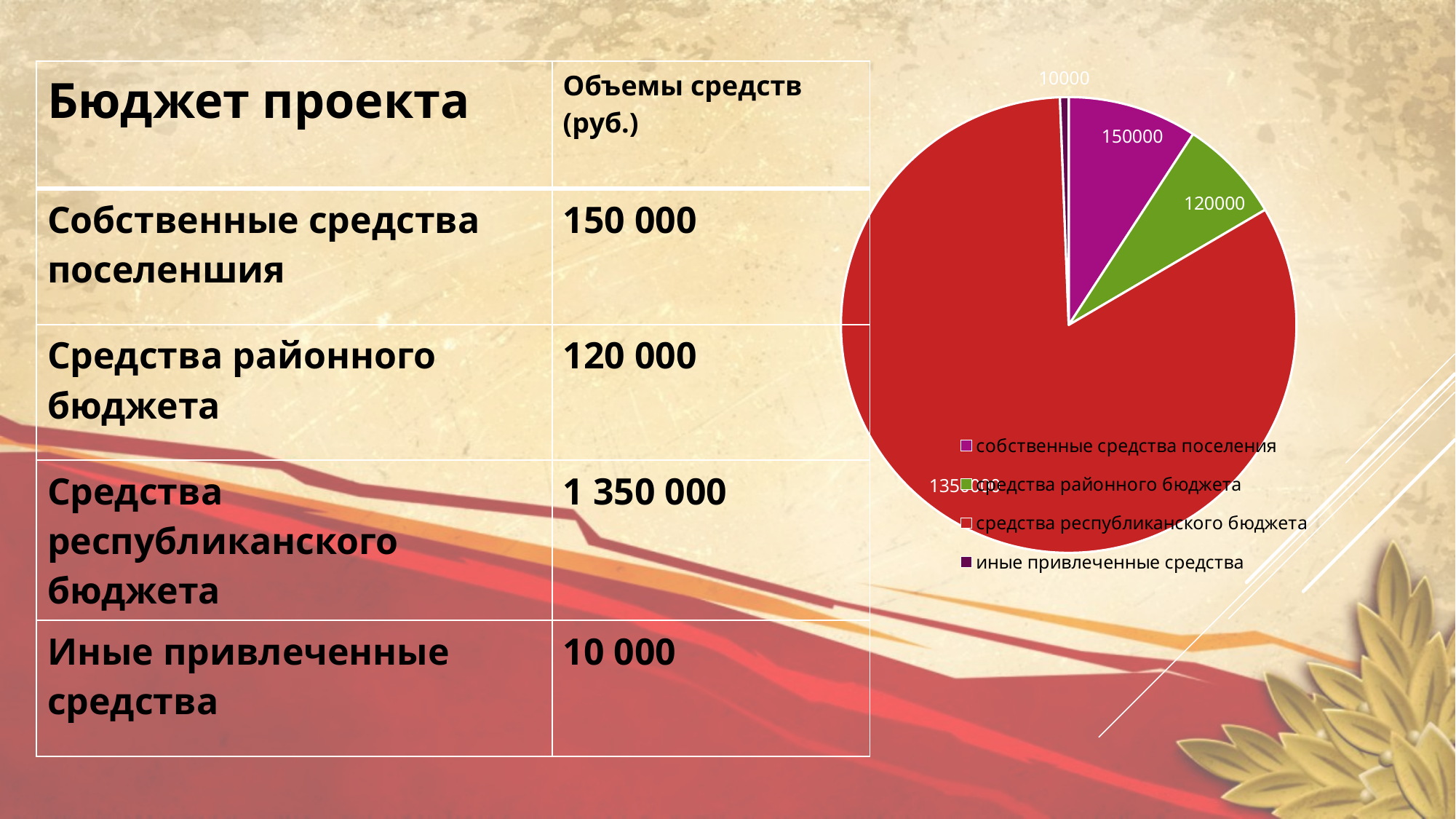
Which category has the largest slice in the pie chart? средства республиканского бюджета What is the value of the slice for собственные средства поселения in the pie chart? 150000 What is the value of the slice for средства республиканского бюджета in the pie chart? 1350000 How many slices does the pie chart have? 4 What is the difference between the values for собственные средства поселения and средства районного бюджета in the pie chart? 30000 What is the value of the slice for средства районного бюджета in the pie chart? 120000 Which is larger in the pie chart: собственные средства поселения or средства районного бюджета? собственные средства поселения What is the value of the slice for иные привлеченные средства in the pie chart? 10000 What colour is the slice for средства районного бюджета in the pie chart? green What kind of chart is shown on the slide? pie chart Which category has the smallest slice in the pie chart? иные привлеченные средства What is the difference between the values for средства республиканского бюджета and иные привлеченные средства in the pie chart? 1340000